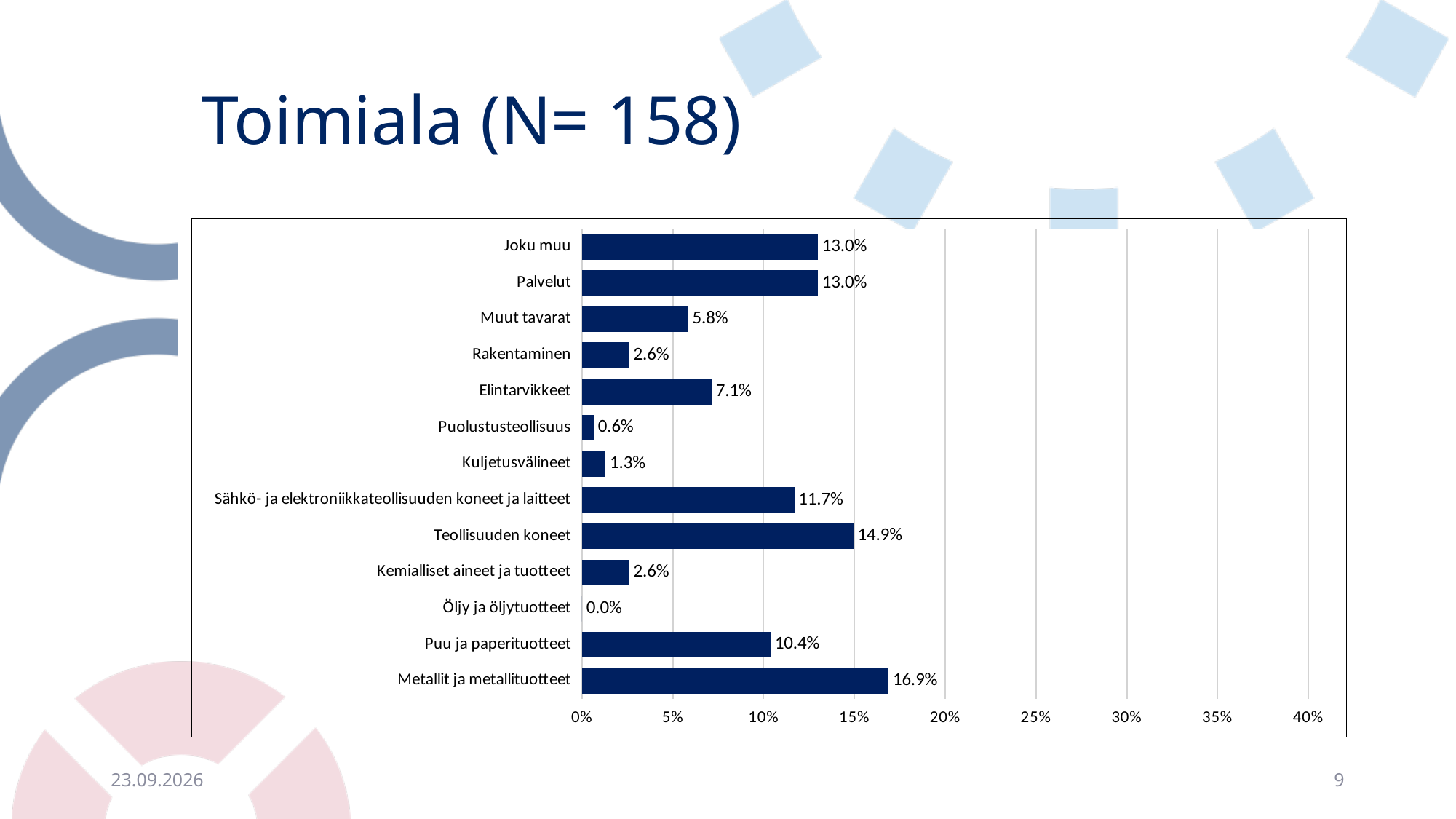
Which category has the highest value? Metallit ja metallituotteet Which category has the lowest value? Öljy ja öljytuotteet What is the value for Metallit ja metallituotteet? 16.9% Is the value for Teollisuuden koneet greater or less than 10%? greater What is the value for Sähkö- ja elektroniikkateollisuuden koneet ja laitteet? 11.7% What is the value for Puolustusteollisuus? 0.6% How many categories are shown in the chart? 13 What kind of chart is shown on the slide? bar chart What is the value for Puu ja paperituotteet? 10.4% Which is larger, the value for Elintarvikkeet or the value for Muut tavarat? Elintarvikkeet What is the difference between the values for Metallit ja metallituotteet and Teollisuuden koneet? 2.0 percentage points What is the title of the slide? Toimiala (N= 158)